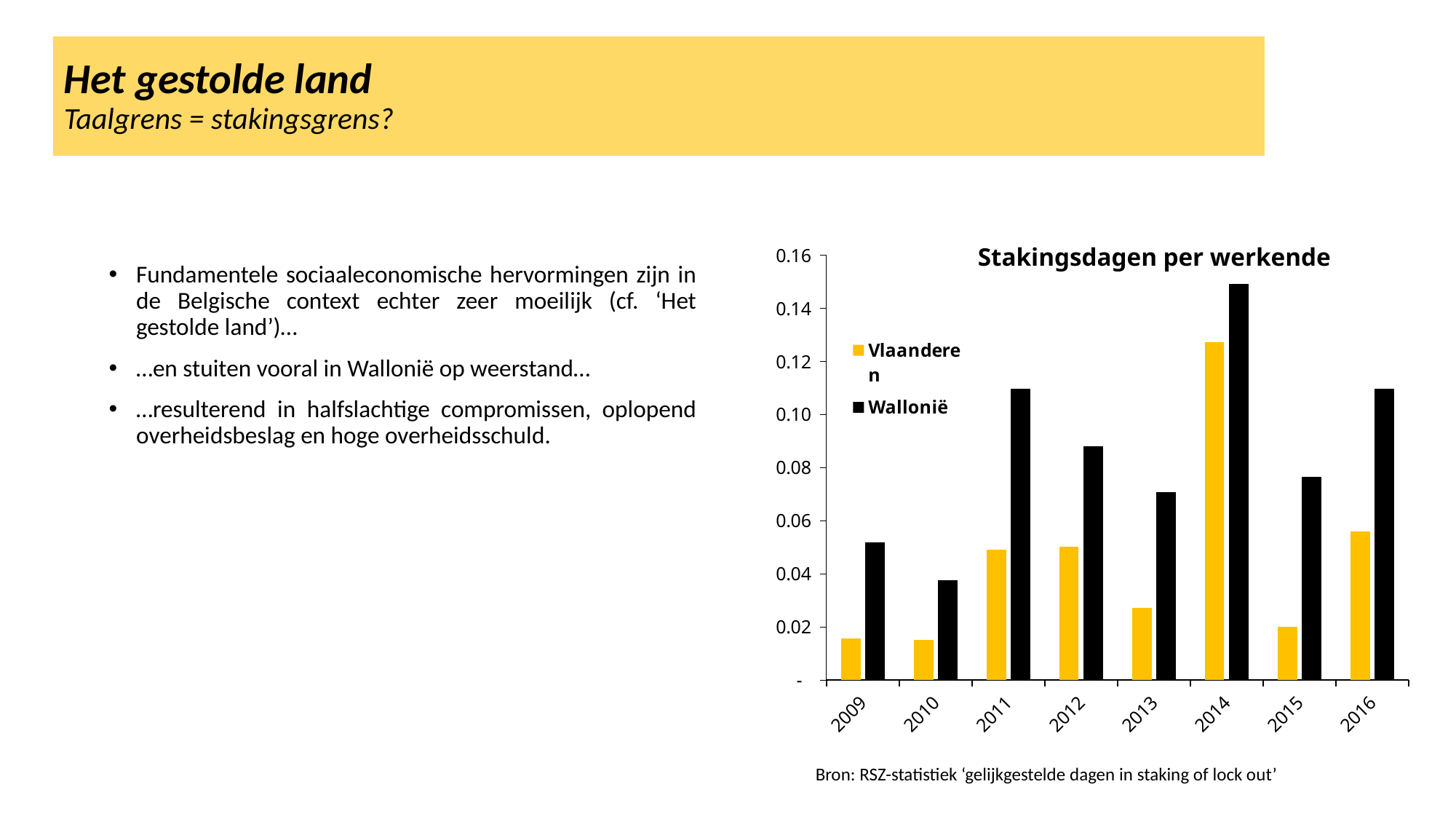
In 2014, which series has the larger value, Vlaanderen or Wallonië? Wallonië Is the value for Wallonië in 2014 greater or less than 0.14? greater What kind of chart is shown on the slide? bar chart What is the title of the chart? Stakingsdagen per werkende Which colour represents Wallonië in the chart? black Is the value for Wallonië in 2011 greater or less than 0.10? greater In which year is the value for Wallonië highest? 2014 In which year is the value for Wallonië lowest? 2010 How many series does the chart's legend list? 2 How many years are shown on the x axis of the chart? 8 In which year is the value for Vlaanderen highest? 2014 Is the value for Vlaanderen in 2013 greater or less than 0.04? less